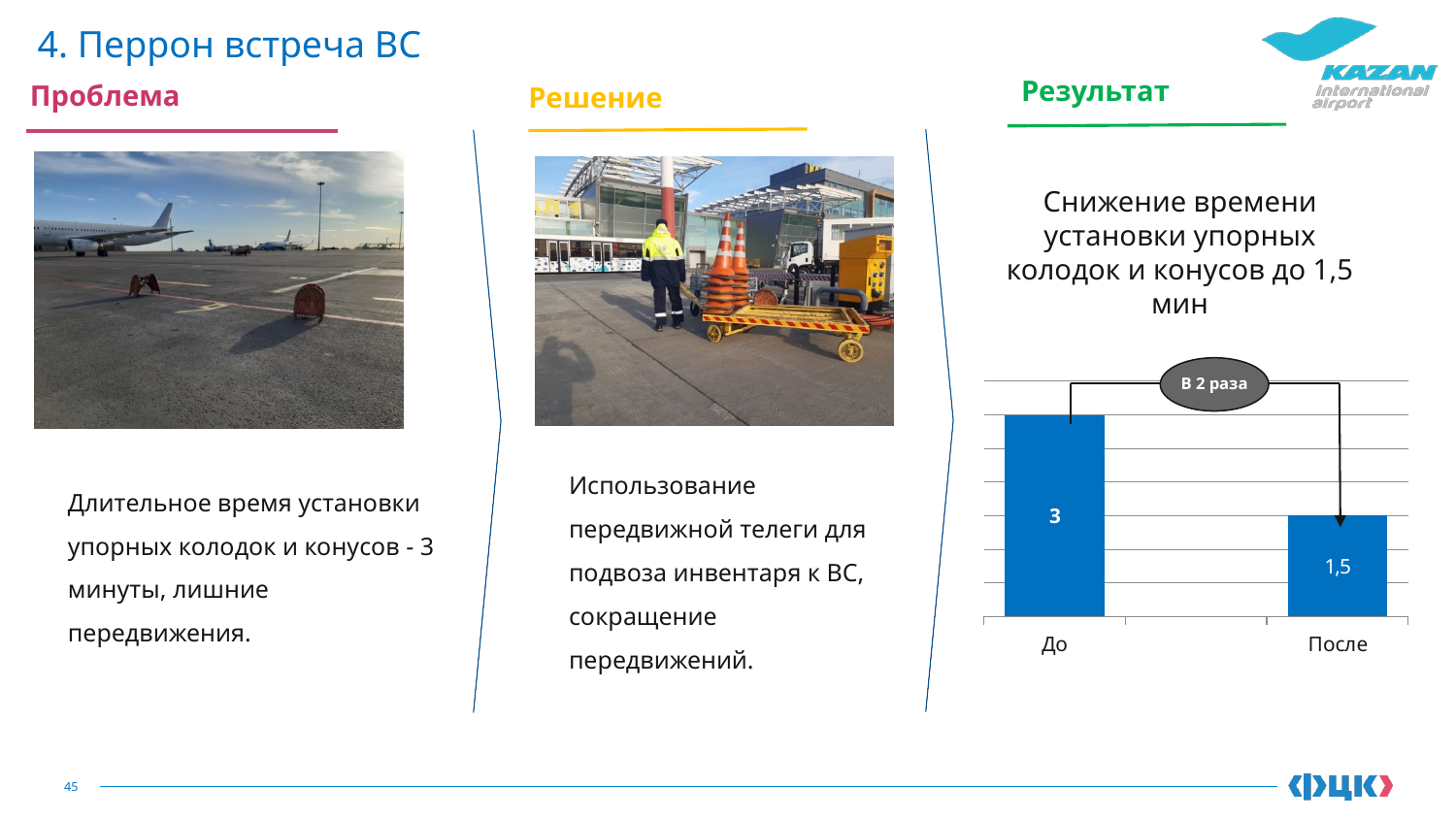
Which is larger, the value for "До" or the value for "После"? До Which category has the lowest value? После What is the difference between the values for "До" and "После"? 1,5 What kind of chart is shown on the slide? Bar chart What is the value for "После"? 1,5 What text is written in the oval annotation above the bars? В 2 раза Do the values rise or fall from "До" to "После"? Fall Which category has the highest value? До What is the value for "До"? 3 How many categories are shown on the x axis of the chart? 2 What colour are the bars in the chart? Blue